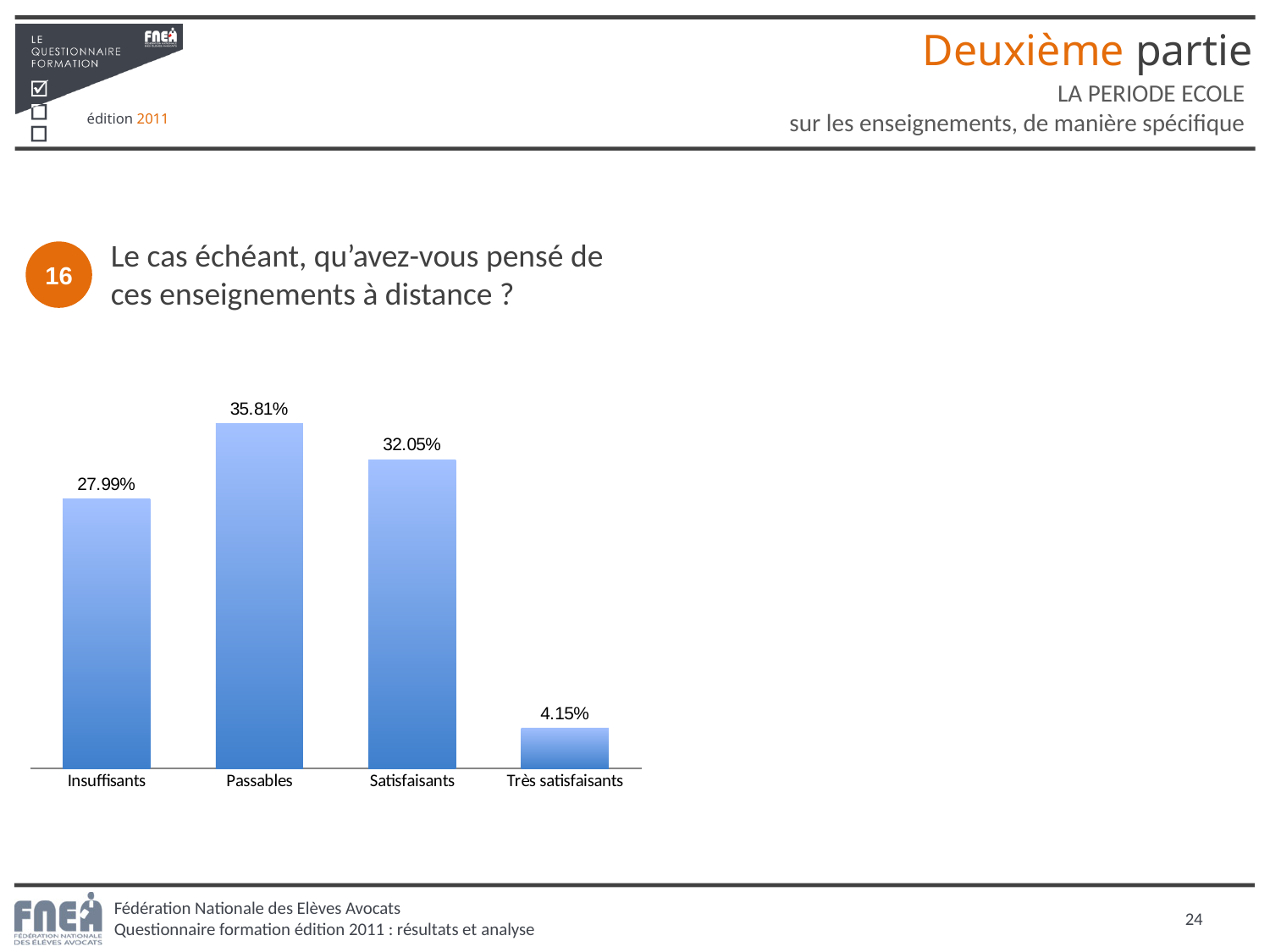
Which category has the highest value? Passables What is the value for Passables? 35.81% Which is larger, the value for Insuffisants or the value for Satisfaisants? Satisfaisants What is the difference between the values for Passables and Satisfaisants? 3.76% Which category has the lowest value? Très satisfaisants How many categories are shown in the chart? 4 What is the difference between the values for Insuffisants and Très satisfaisants? 23.84% What kind of chart is shown on the slide? Bar chart What is the value for Très satisfaisants? 4.15% What is the value for Insuffisants? 27.99% What is the value for Satisfaisants? 32.05% What is the number of the survey question shown on the slide? 16